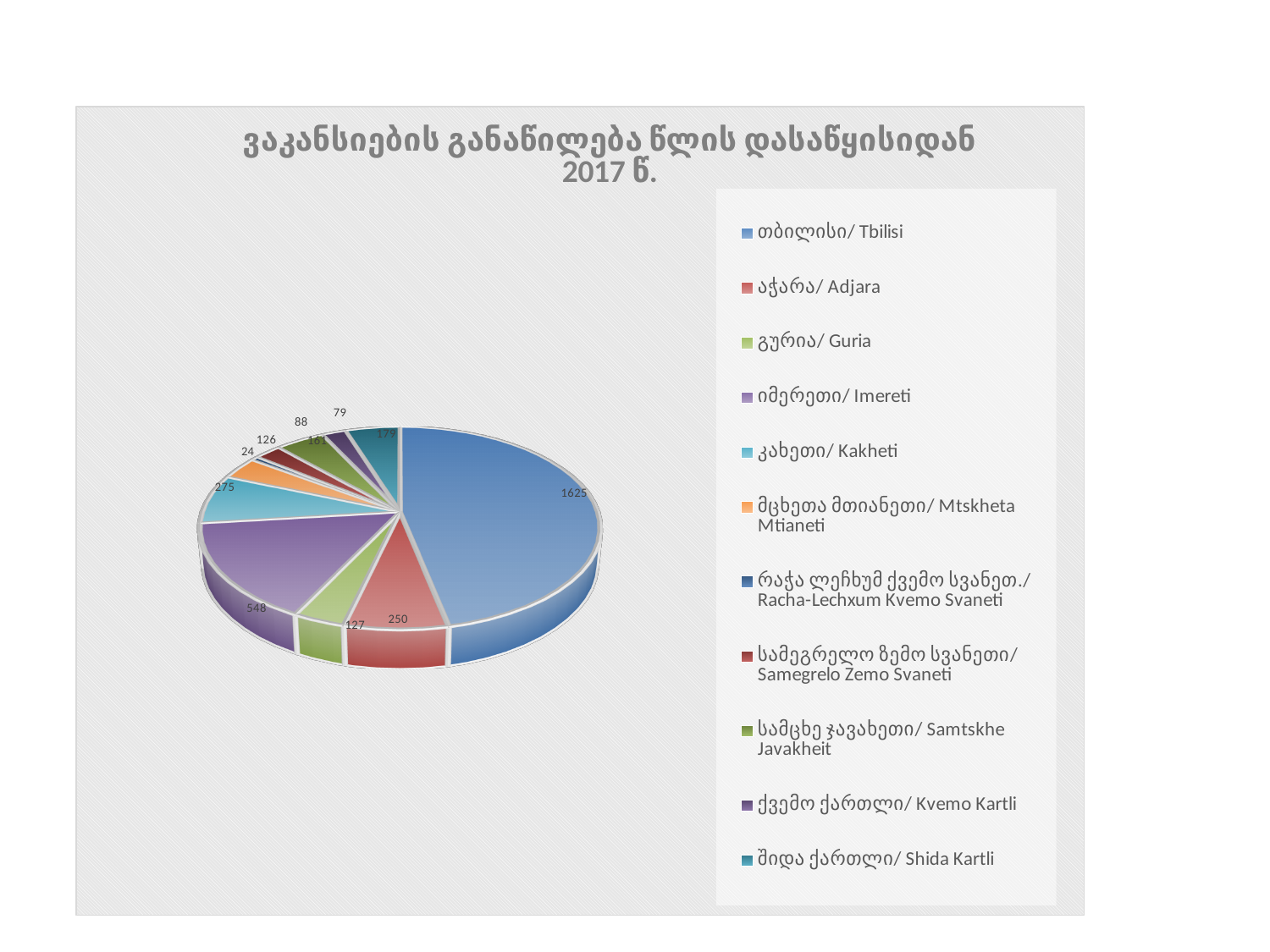
What is the value for მცხეთა მთიანეთი/ Mtskheta Mtianeti? 126 Which region has the largest slice of the pie? თბილისი/ Tbilisi What is the difference between the values for შიდა ქართლი/ Shida Kartli and ქვემო ქართლი/ Kvemo Kartli? 100 What type of chart is shown on the slide? Pie chart What is the value for კახეთი/ Kakheti? 275 What is the title of the chart? ვაკანსიების განაწილება წლის დასაწყისიდან 2017 წ. Which region has the smallest slice of the pie? რაჭა ლეჩხუმ ქვემო სვანეთ./ Racha-Lechxum Kvemo Svaneti What is the value for თბილისი/ Tbilisi? 1625 What is the difference between the values for თბილისი/ Tbilisi and იმერეთი/ Imereti? 1077 Which is larger, the value for აჭარა/ Adjara or the value for გურია/ Guria? აჭარა/ Adjara What is the value for იმერეთი/ Imereti? 548 How many regions are listed in the legend? 11